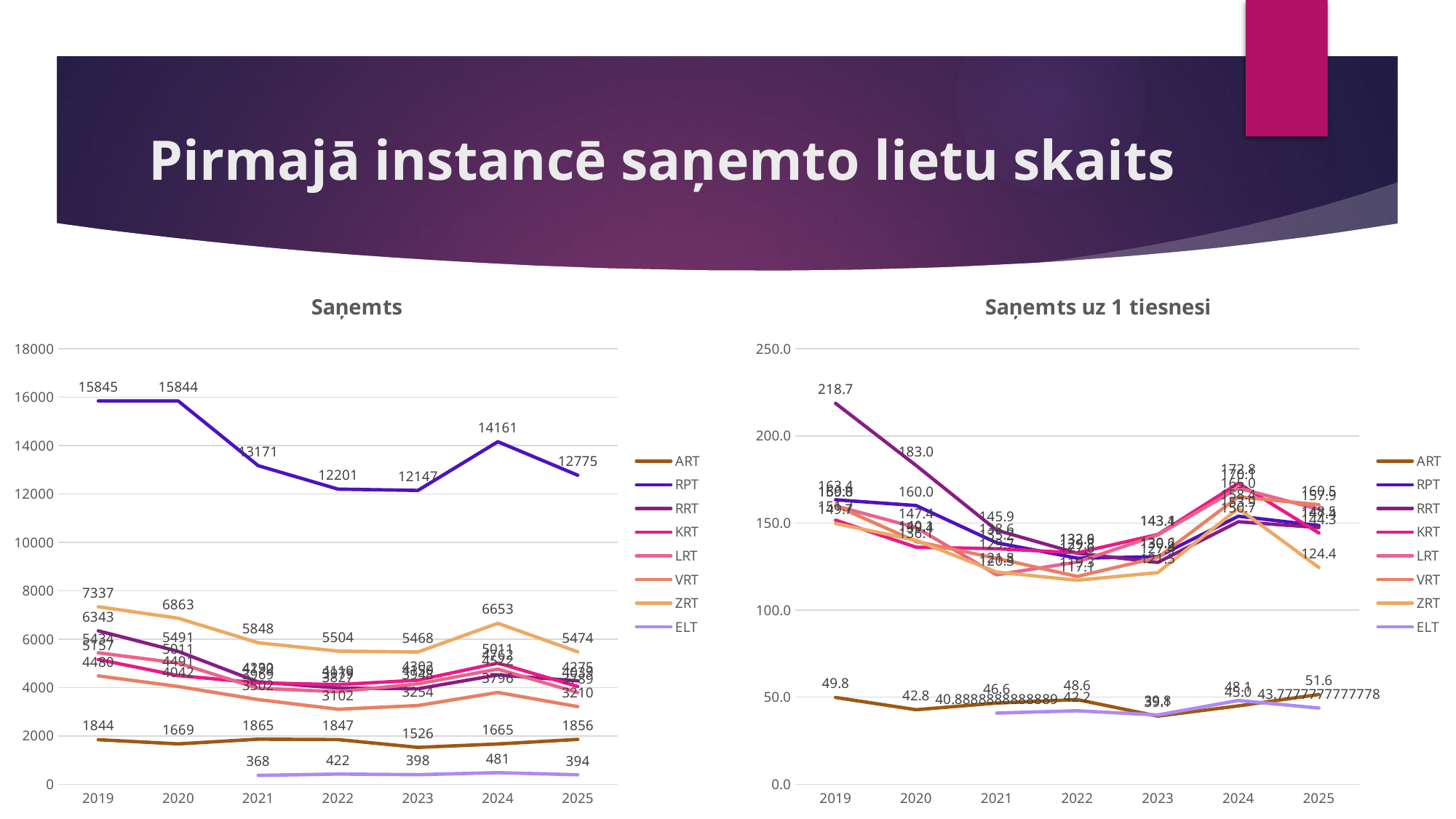
In the chart titled "Saņemts uz 1 tiesnesi", is the value for ART in 2019 greater or less than 100.0? less In the chart titled "Saņemts", how many series does the legend list? 8 In the chart titled "Saņemts", what is the value for ART in 2023? 1526 In the chart titled "Saņemts uz 1 tiesnesi", what is the value for ZRT in 2025? 124.4 In the chart titled "Saņemts", what is the value for RPT in 2019? 15845 In the chart titled "Saņemts uz 1 tiesnesi", what is the value for RRT in 2019? 218.7 In the chart titled "Saņemts", what is the difference between the RPT values in 2024 and 2025? 1386 What kind of chart is the chart titled "Saņemts uz 1 tiesnesi"? line chart In the chart titled "Saņemts", in which year is the ELT value lowest? 2021 In the chart titled "Saņemts", in which year is the RPT value highest? 2019 In the chart titled "Saņemts", what is the value for ZRT in 2024? 6653 In the chart titled "Saņemts", which is larger in 2022: the ZRT value or the VRT value? ZRT